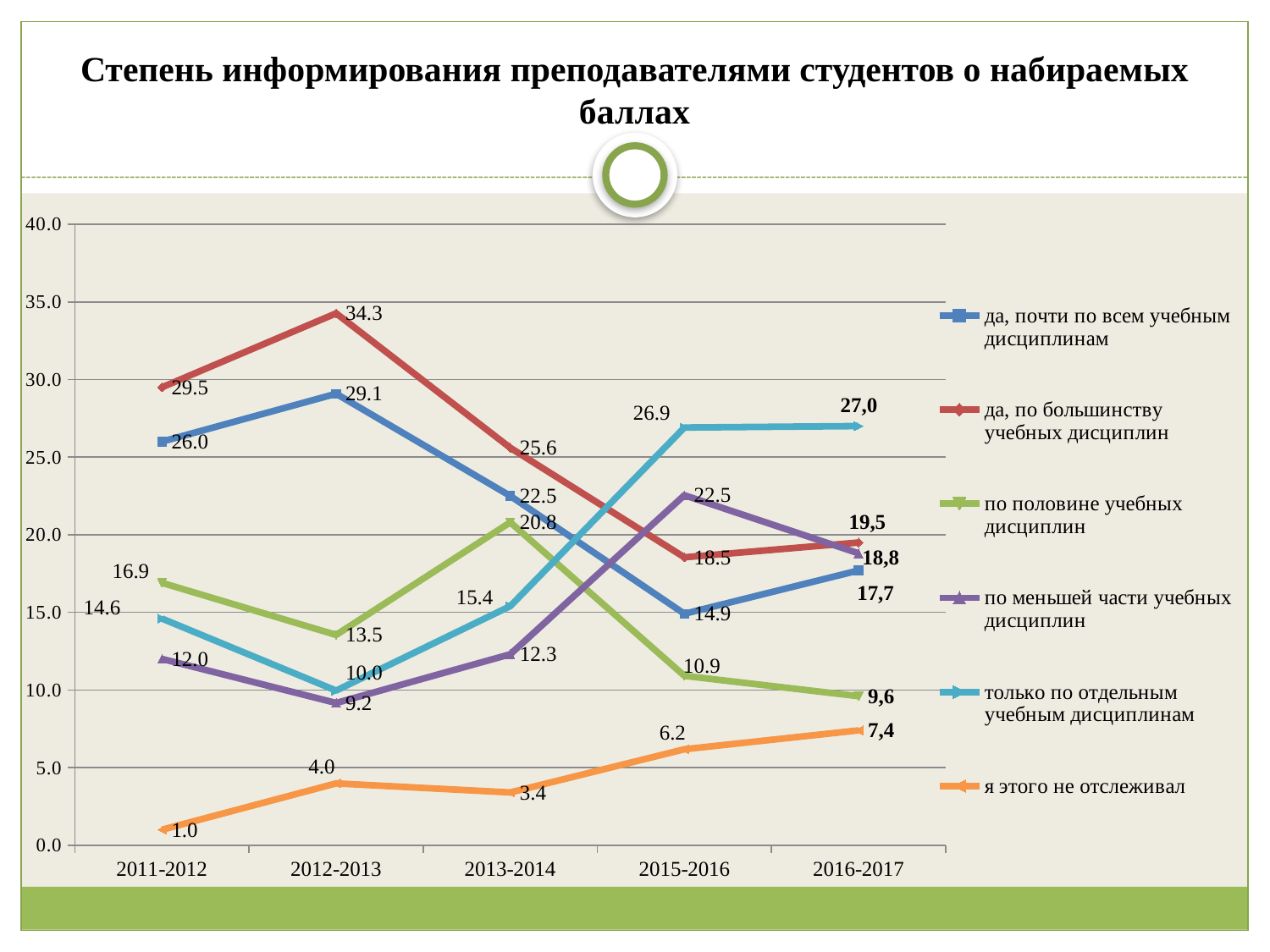
What is the value for "только по отдельным учебным дисциплинам" in 2016-2017? 27,0 What is the value for "да, по большинству учебных дисциплин" in 2012-2013? 34.3 What is the title of the chart? Степень информирования преподавателями студентов о набираемых баллах In which year does the series "да, по большинству учебных дисциплин" reach its highest value? 2012-2013 Does the series "я этого не отслеживал" generally rise or fall from 2011-2012 to 2016-2017? rise How many series does the legend list? 6 What is the difference between the values for "да, почти по всем учебным дисциплинам" in 2012-2013 and 2013-2014? 6.6 In which year is the value for "я этого не отслеживал" lowest? 2011-2012 In 2015-2016, which is larger: "только по отдельным учебным дисциплинам" or "по меньшей части учебных дисциплин"? только по отдельным учебным дисциплинам How many academic-year categories are shown on the x axis? 5 What is the value for "по половине учебных дисциплин" in 2013-2014? 20.8 What kind of chart is shown on the slide? line chart